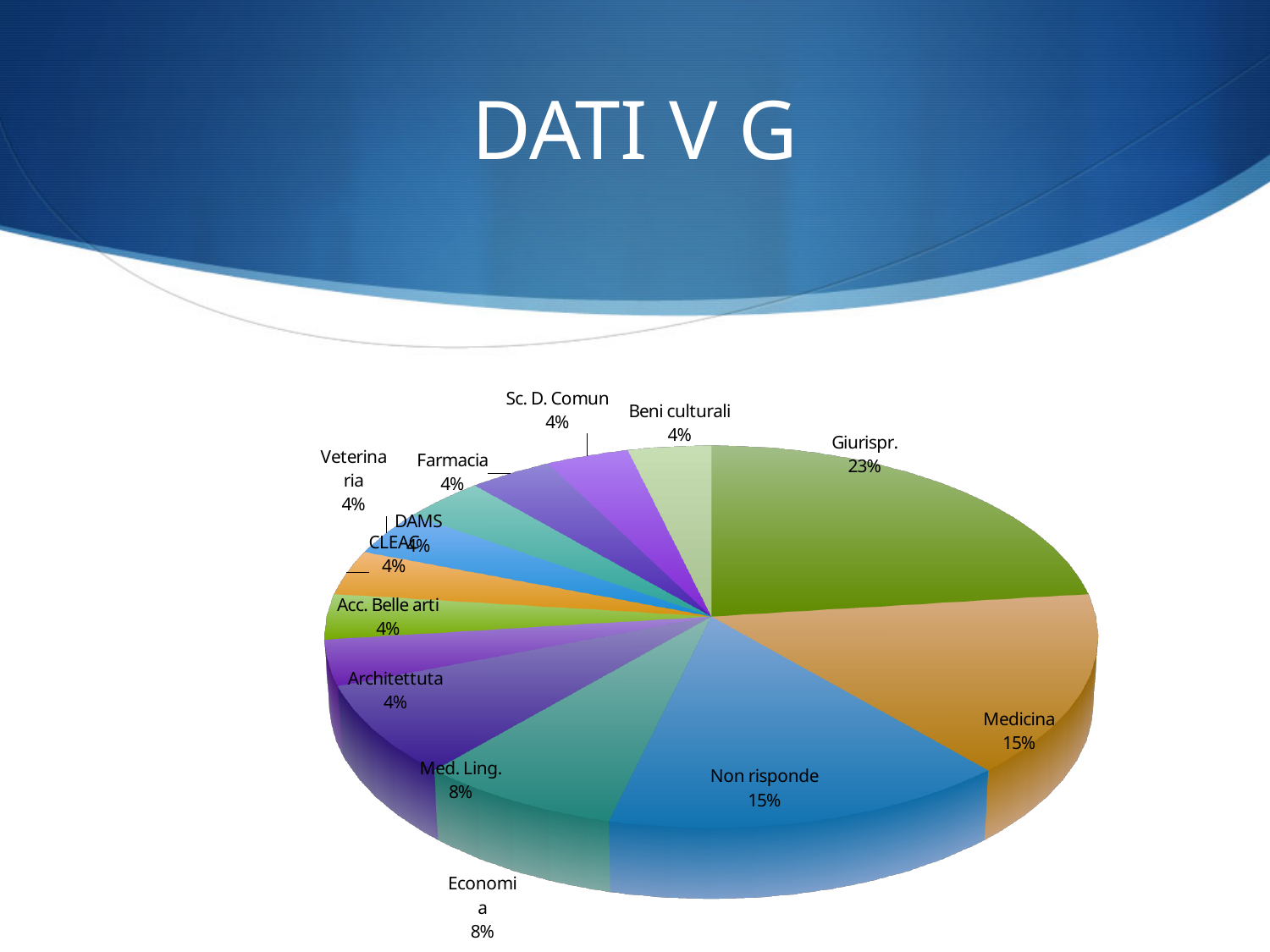
What percentage is shown for Economia? 8% What percentage is shown for Farmacia? 4% What type of chart is shown on the slide? pie chart How many slices does the pie chart have? 13 What is the difference in percentage points between Med. Ling. and Architettuta? 4 What percentage of the pie does Giurispr. represent? 23% What is the difference in percentage points between Giurispr. and Medicina? 8 Which category has the largest slice of the pie? Giurispr. What is the value shown for Non risponde? 15% Which is larger, the slice for Economia or the slice for Beni culturali? Economia What is the title of the slide containing the pie chart? DATI V G What is the value shown for Medicina? 15%